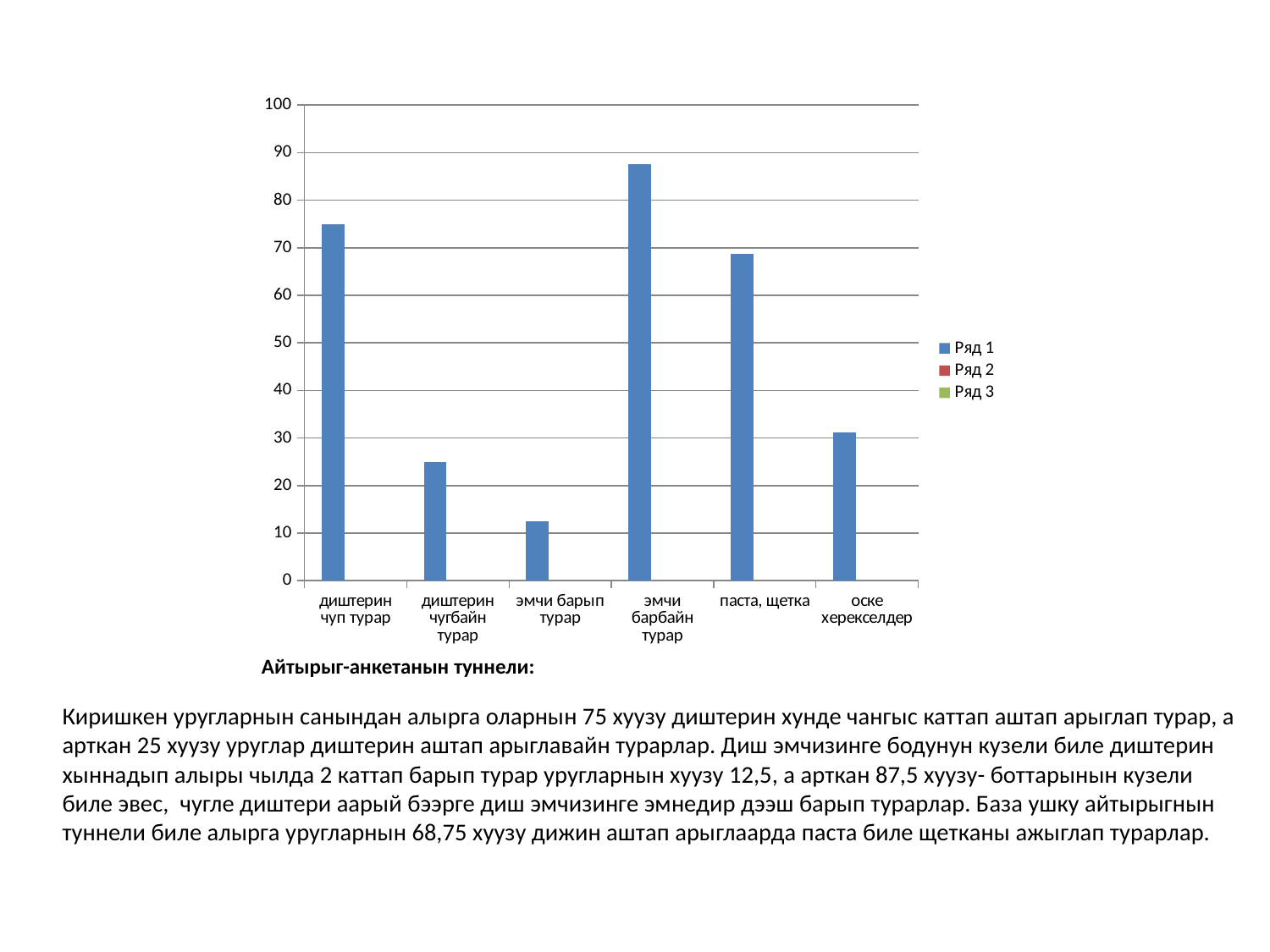
Which is larger, the value for паста, щетка or the value for оске херекселдер? паста, щетка How many series does the chart's legend list? 3 Which is larger, the value for диштерин чуп турар or the value for диштерин чугбайн турар? диштерин чуп турар Is the value for диштерин чугбайн турар greater or less than 30? less Which category has the highest bar in the chart? эмчи барбайн турар What kind of chart is shown on the slide? bar chart Which category has the lowest bar in the chart? эмчи барып турар Is the value for диштерин чуп турар greater or less than 70? greater How many categories are shown on the x axis of the chart? 6 What is the name of the first series listed in the chart's legend? Ряд 1 Is the value for оске херекселдер greater or less than 40? less